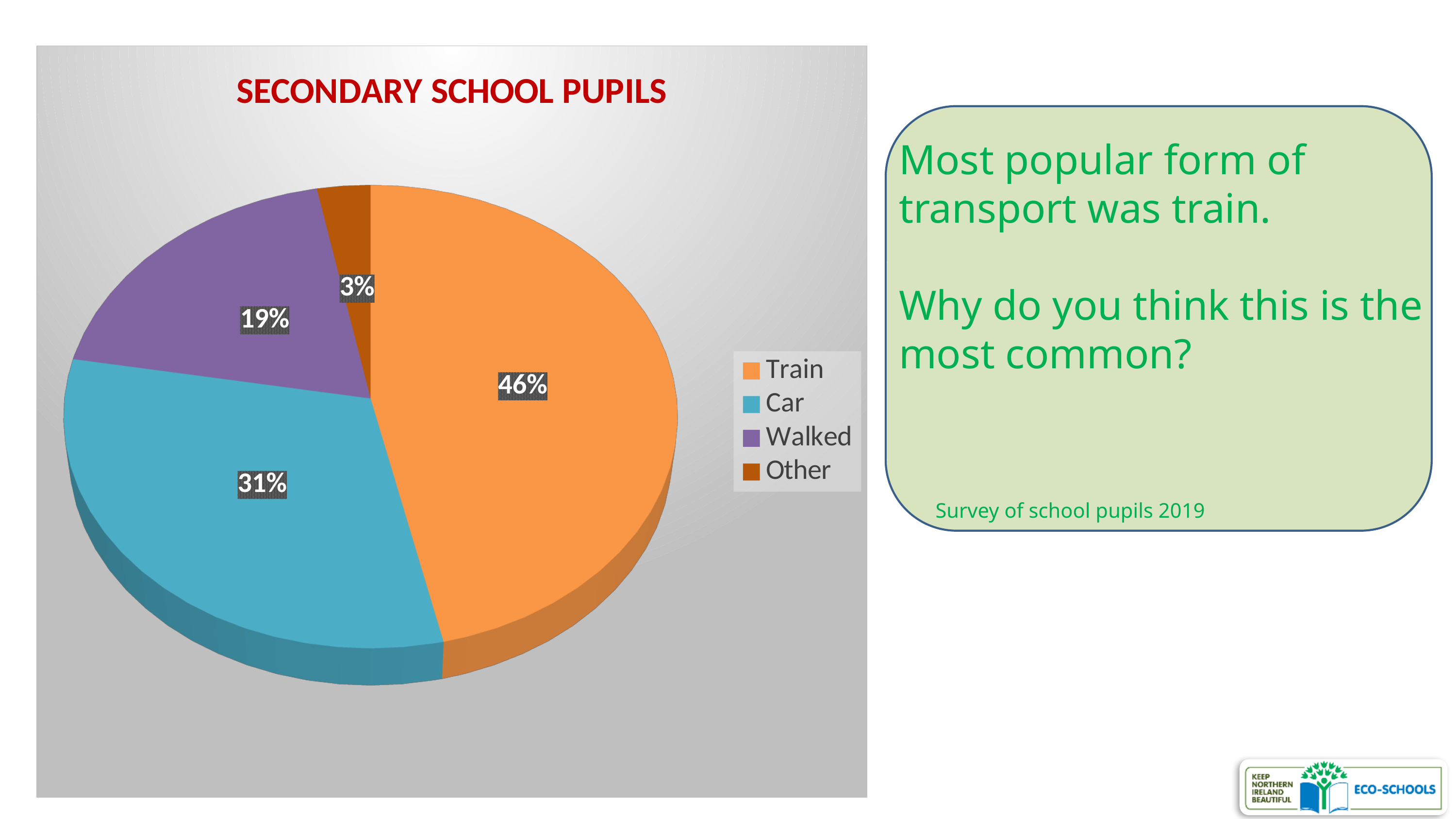
What percentage of secondary school pupils used 'Other' forms of transport? 3% Which is larger, the share for Car or the share for Walked? Car What is the difference in percentage points between the Train and Car slices? 15 What percentage of secondary school pupils walked? 19% Which form of transport has the largest share of the pie? Train What percentage of secondary school pupils travelled by car? 31% What is the title of the chart? SECONDARY SCHOOL PUPILS Which form of transport has the smallest share of the pie? Other How many categories are shown in the pie chart? 4 What percentage of secondary school pupils travelled by train? 46% What kind of chart is shown on the slide? Pie chart What colour is the Walked slice in the pie chart? Purple